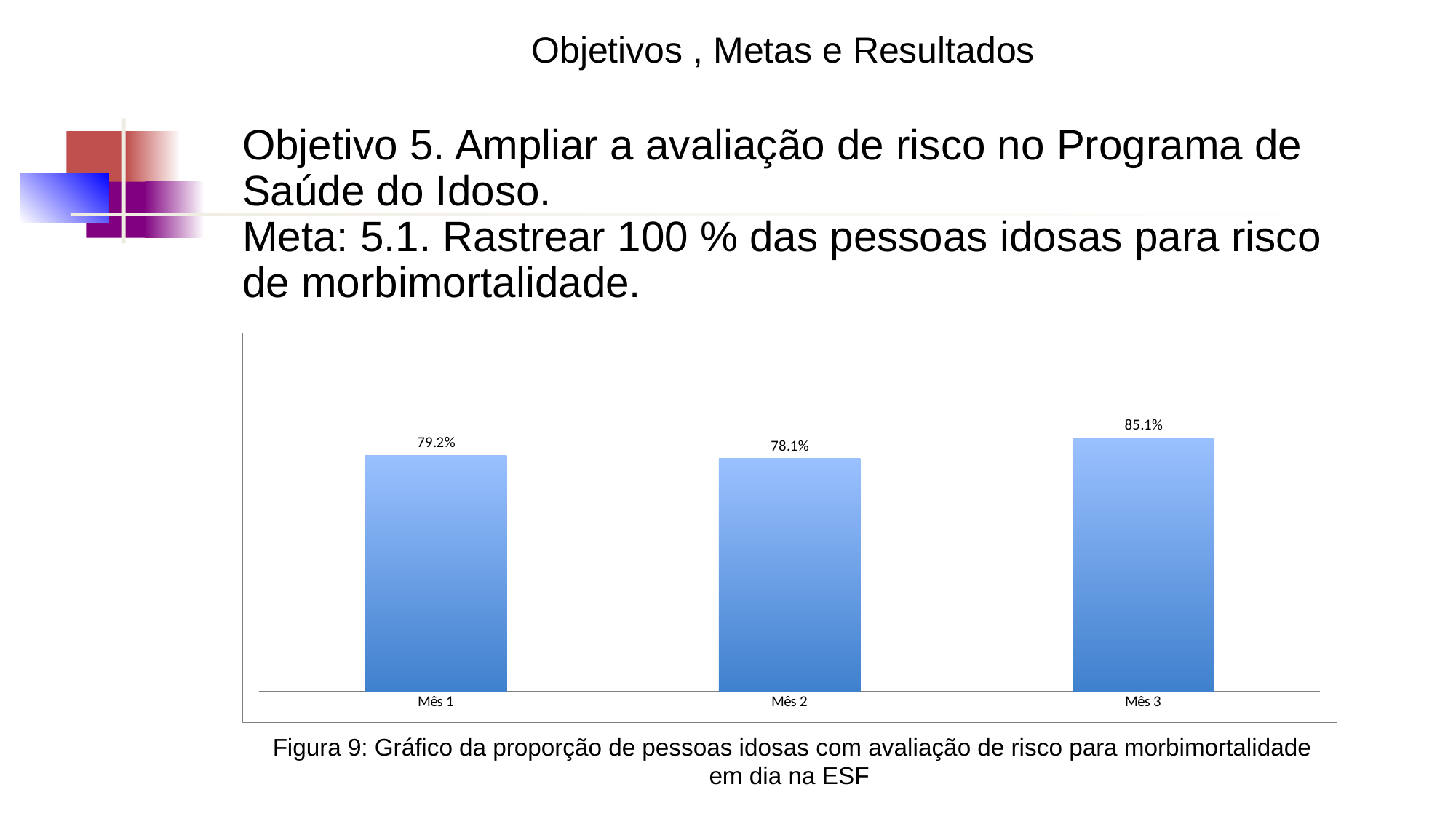
What is the difference between the values for Mês 3 and Mês 1? 5.9% What kind of chart is shown on the slide? Bar chart Which month has the highest value? Mês 3 Does the value rise or fall from Mês 2 to Mês 3? Rise Which is larger, the value for Mês 3 or the value for Mês 2? Mês 3 What is the figure number given in the caption below the chart? Figura 9 What is the value for Mês 1? 79.2% How many categories are shown in the chart? 3 What is the value for Mês 3? 85.1% Which month has the lowest value? Mês 2 What is the value for Mês 2? 78.1% What is the difference between the values for Mês 1 and Mês 2? 1.1%